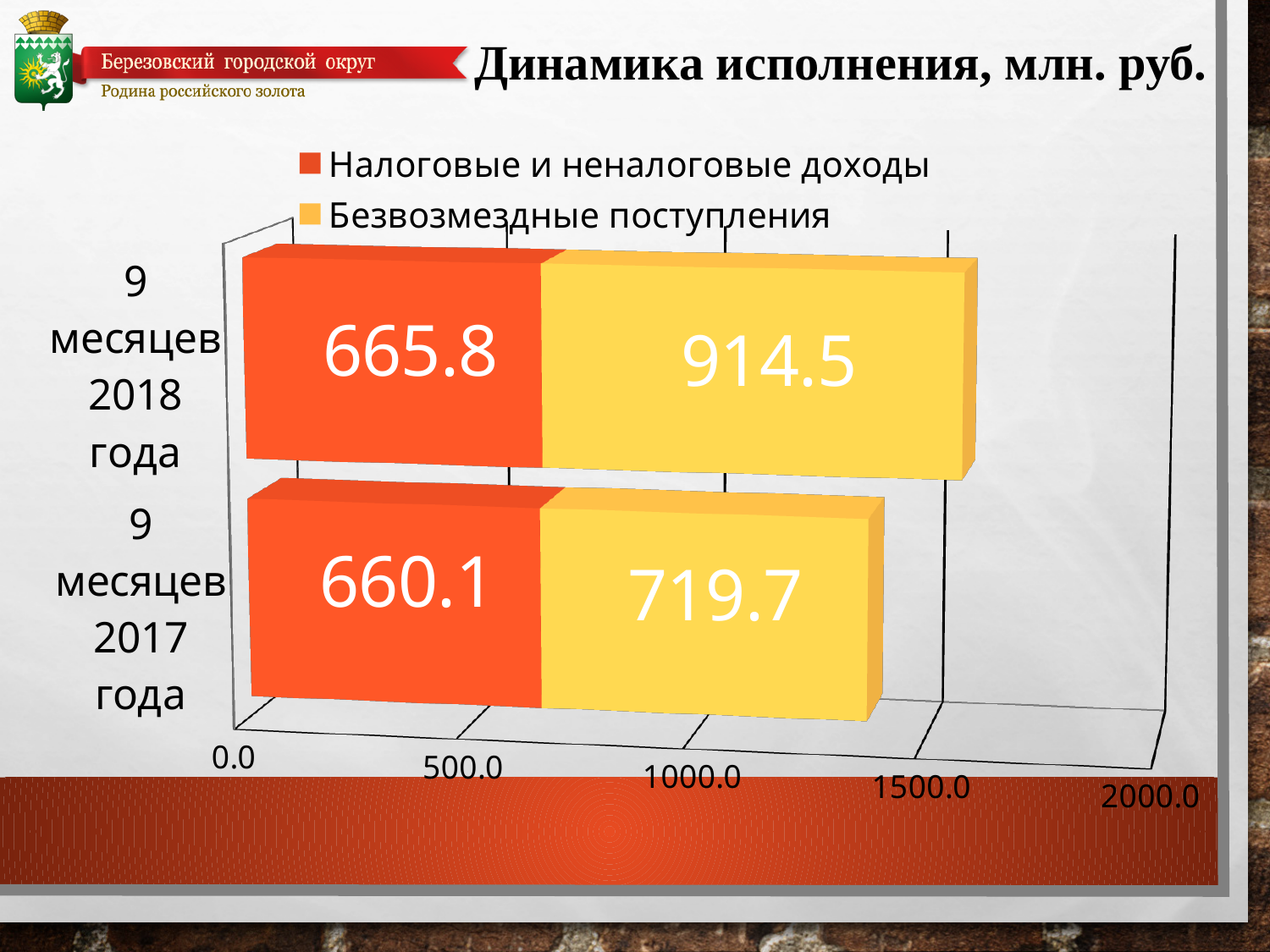
What is the value of Налоговые и неналоговые доходы for 9 месяцев 2018 года? 665.8 What is the total of the stacked bar for 9 месяцев 2018 года? 1580.3 What is the total of the stacked bar for 9 месяцев 2017 года? 1379.8 What is the difference between Налоговые и неналоговые доходы for 9 месяцев 2018 года and 9 месяцев 2017 года? 5.7 What is the difference between Безвозмездные поступления for 9 месяцев 2018 года and 9 месяцев 2017 года? 194.8 What is the value of Налоговые и неналоговые доходы for 9 месяцев 2017 года? 660.1 What kind of chart is shown on the slide? Stacked bar chart How many series does the legend list? 2 What is the title of the chart? Динамика исполнения, млн. руб. What is the value of Безвозмездные поступления for 9 месяцев 2017 года? 719.7 Which period has the higher value for Безвозмездные поступления? 9 месяцев 2018 года What is the value of Безвозмездные поступления for 9 месяцев 2018 года? 914.5